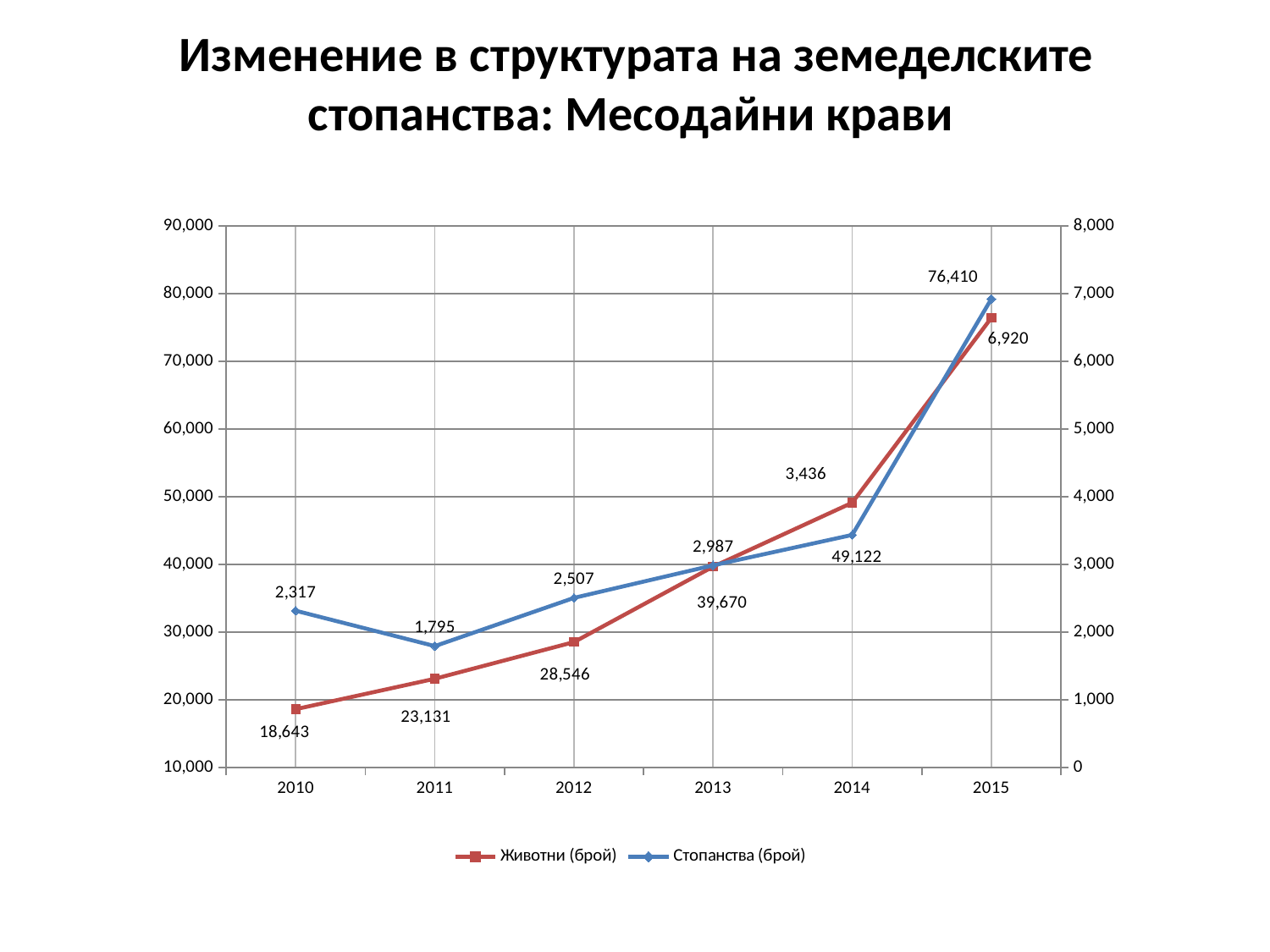
In which year is Животни (брой) highest? 2015 What kind of chart is shown on the slide? Line chart In which year is Стопанства (брой) lowest? 2011 How many years are shown on the x axis? 6 How many series does the legend list? 2 What is the value of Животни (брой) in 2015? 76,410 What is the value of Стопанства (брой) in 2011? 1,795 Which year has a larger value for Стопанства (брой), 2010 or 2012? 2012 What is the difference in Стопанства (брой) between 2012 and 2011? 712 Does Животни (брой) rise or fall from 2010 to 2015? Rise What is the value of Животни (брой) in 2013? 39,670 What is the difference in Животни (брой) between 2015 and 2014? 27,288